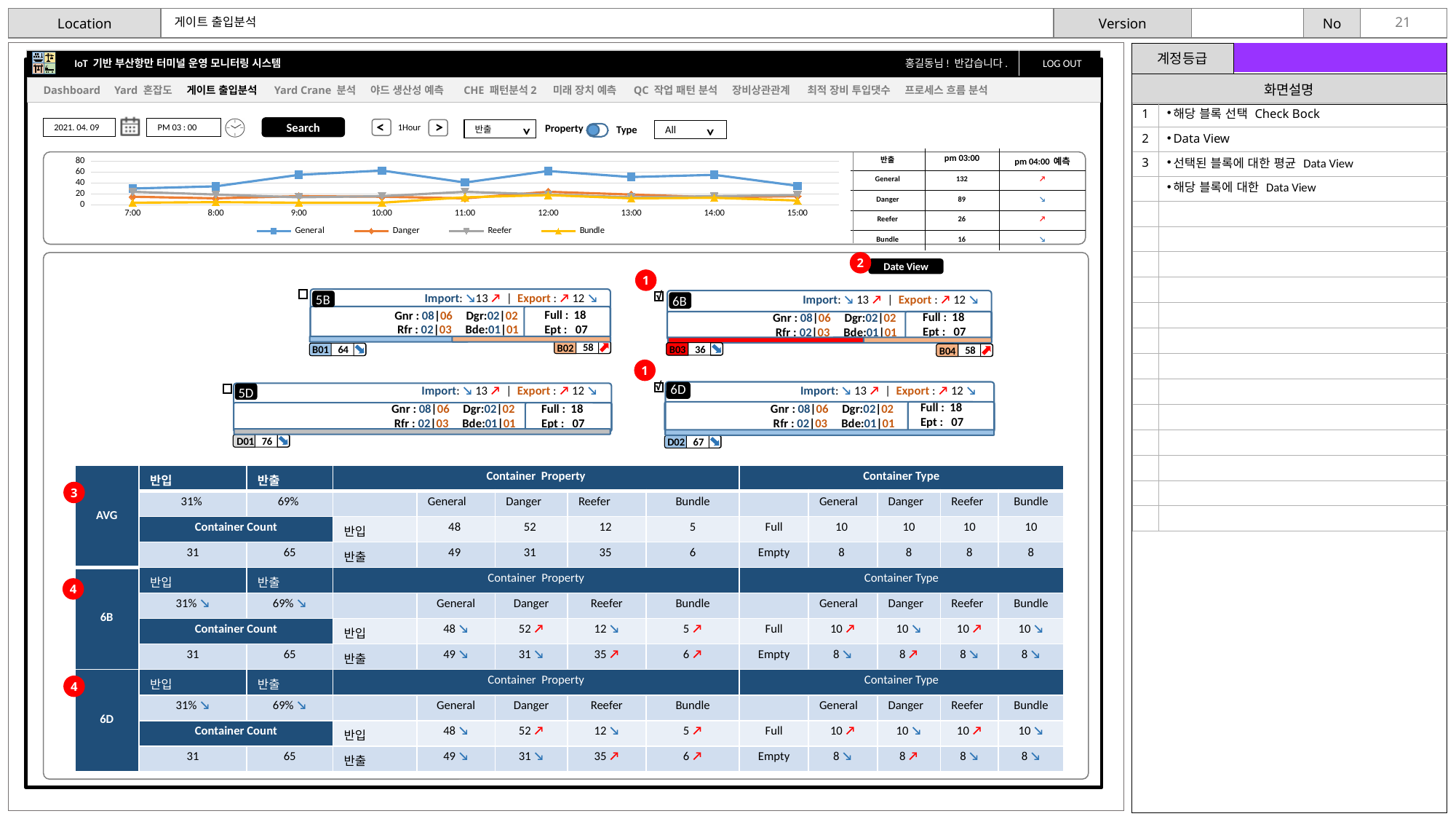
What kind of chart is shown at the top of the slide? line chart What is the highest tick value shown on the y axis of the line chart? 80 At 12:00, which is larger on the line chart: General or Bundle? General What is the first time label on the x axis of the line chart? 7:00 Is the value for General at 12:00 greater or less than 40? greater Is the value for Bundle at 7:00 greater or less than 20? less How many series does the legend of the line chart list? 4 Is the value for General at 7:00 greater or less than 40? less How many time points are plotted along the x axis of the line chart? 9 Which series has the highest values across the line chart? General